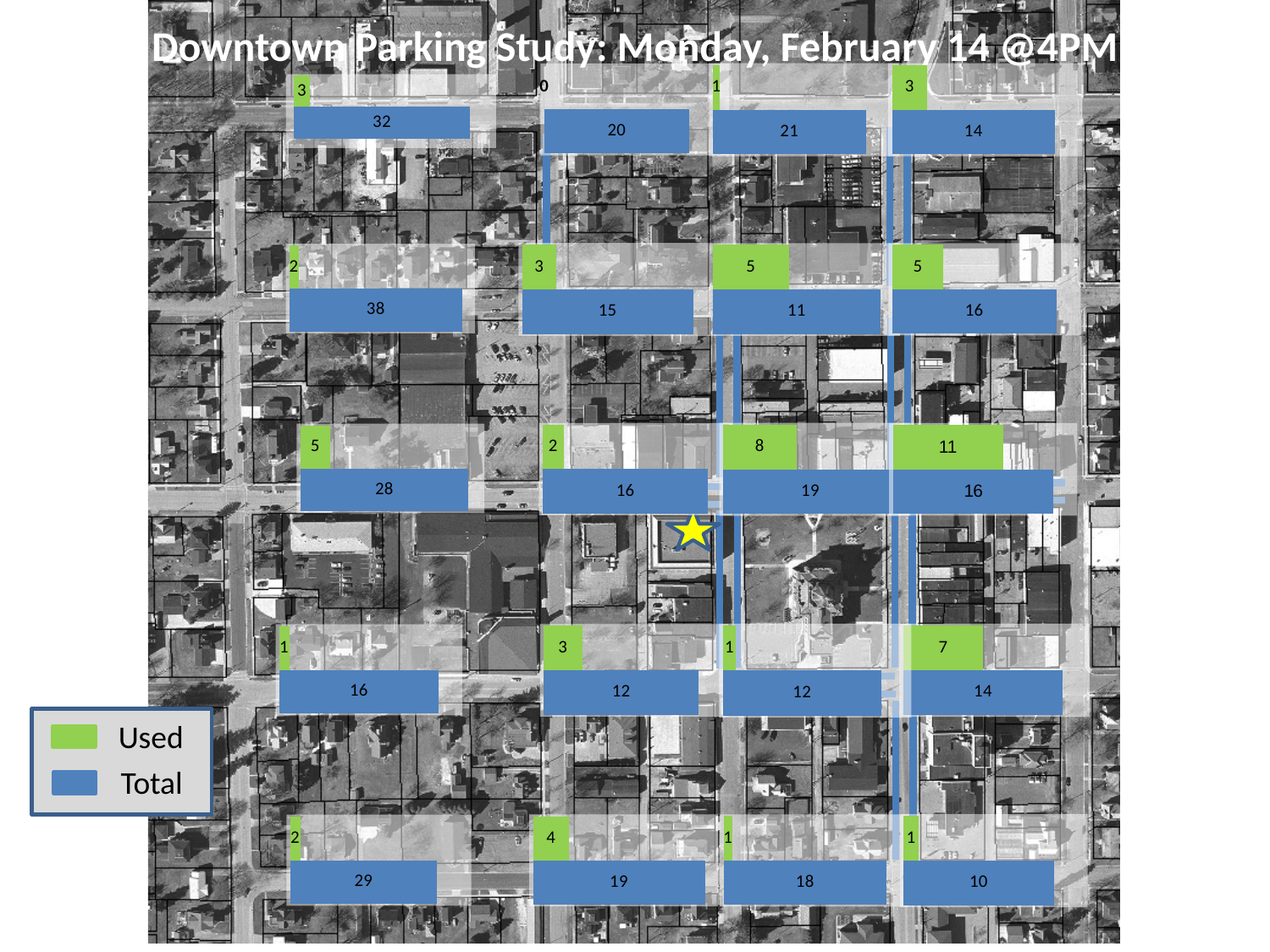
What is the smallest Total value shown on any block? 10 What is the Total value for the block in the bottom-right corner of the map? 10 For the block with a Total of 38 and 2 Used, what is the difference between Total and Used? 36 What is the smallest Used value shown on any block? 0 What is the largest Used value shown on any block? 11 What is the largest Total value shown on any block? 38 Which colour represents the Used series in the legend? Green What is the Used value for the block in the top-left corner of the map? 3 What is the Total value for the block in the top-left corner of the map? 32 How many series does the legend list? 2 What is the title of the slide? Downtown Parking Study: Monday, February 14 @4PM For the block with a Total of 38, how many spaces are Used? 2